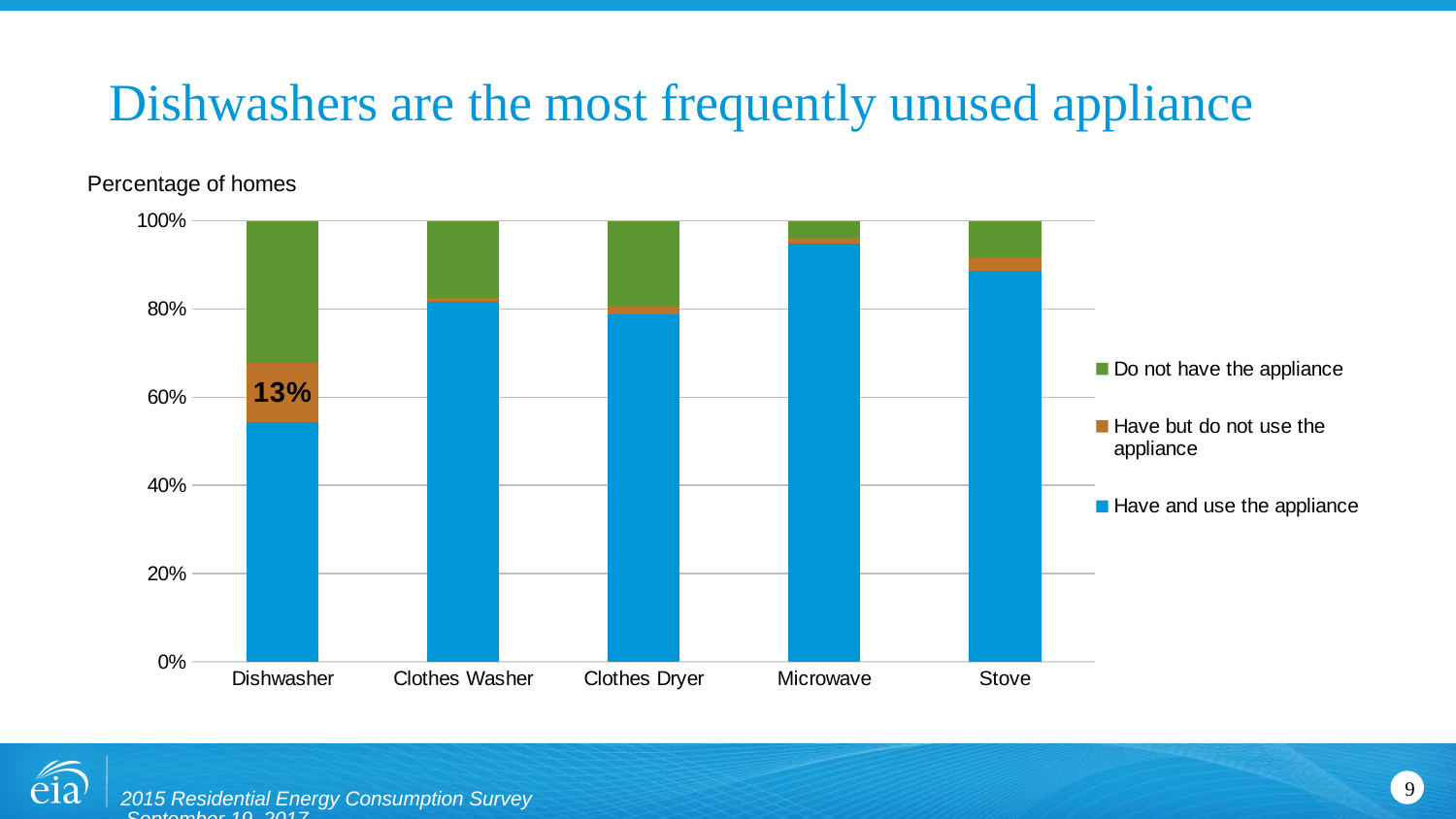
Which appliance has the largest share of homes that have and use it? Microwave What kind of chart is shown on the slide? Stacked bar chart What is the title shown above the chart? Percentage of homes Which is larger: the share of homes that have and use a microwave, or the share that have and use a stove? Microwave Which appliance has the largest share of homes that do not have it? Dishwasher Is the share of homes that have and use a dishwasher greater or less than 60%? less How many appliance categories are shown on the x axis? 5 What is the total of the stacked bar for Dishwasher? 100% What percentage of homes have but do not use a dishwasher? 13% How many series does the legend list? 3 Is the share of homes that have and use a stove greater or less than 80%? greater Which appliance has the smallest share of homes that have and use it? Dishwasher